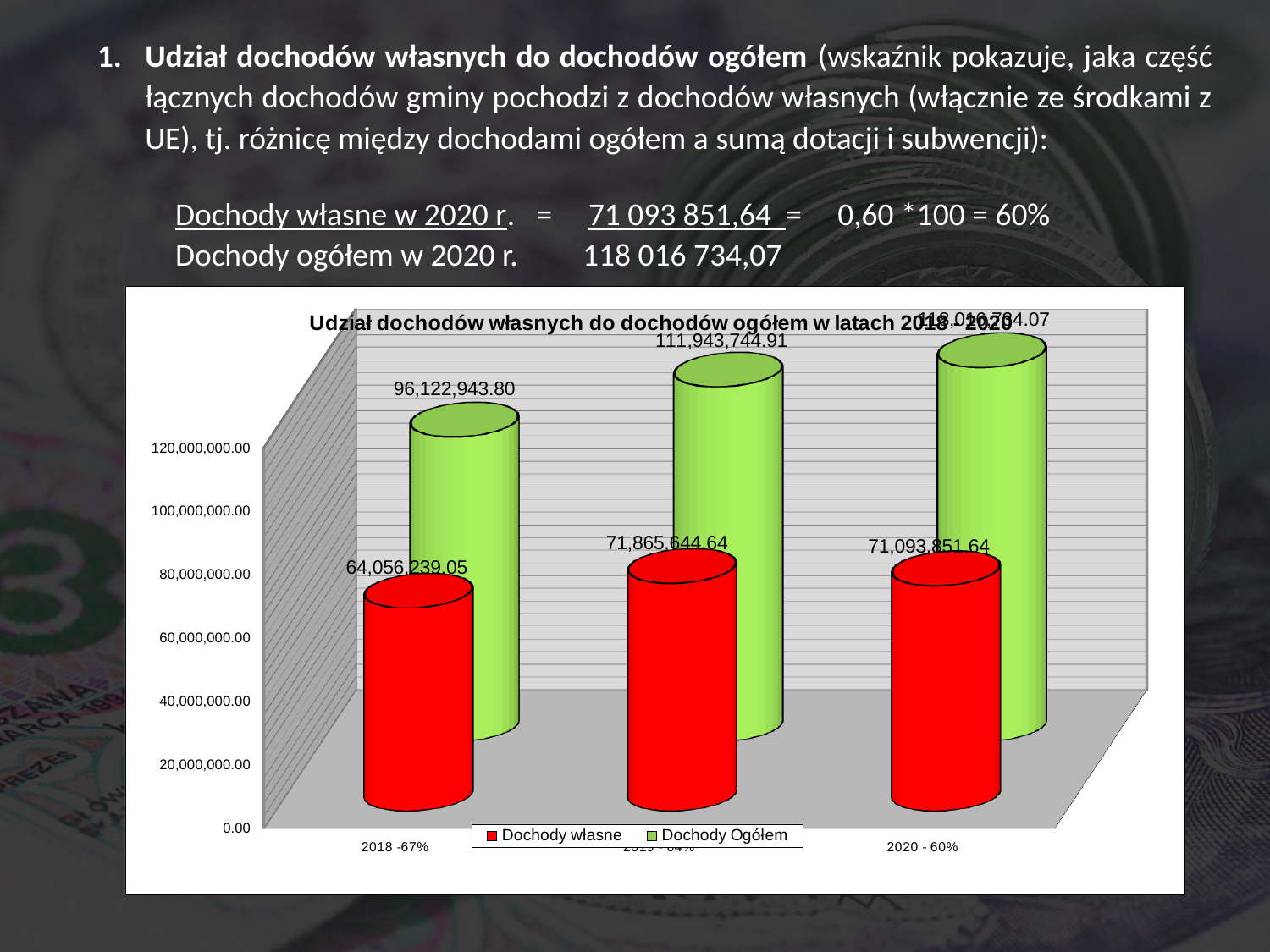
How many series does the chart legend list? 2 What is the value of Dochody Ogółem for 2019? 111,943,744.91 How many years (categories) are shown on the x axis of the chart? 3 Which is larger: Dochody własne in 2019 or in 2020? 2019 What is the difference between Dochody Ogółem in 2019 and in 2018? 15,820,801.11 What is the value of Dochody własne for 2020? 71,093,851.64 What kind of chart is shown on the slide? bar chart In which year is Dochody własne the lowest? 2018 In which year is Dochody Ogółem the highest? 2020 What colour are the Dochody własne bars in the chart? red Do the Dochody Ogółem values rise or fall from 2018 to 2020? rise What is the value of Dochody własne for 2018? 64,056,239.05